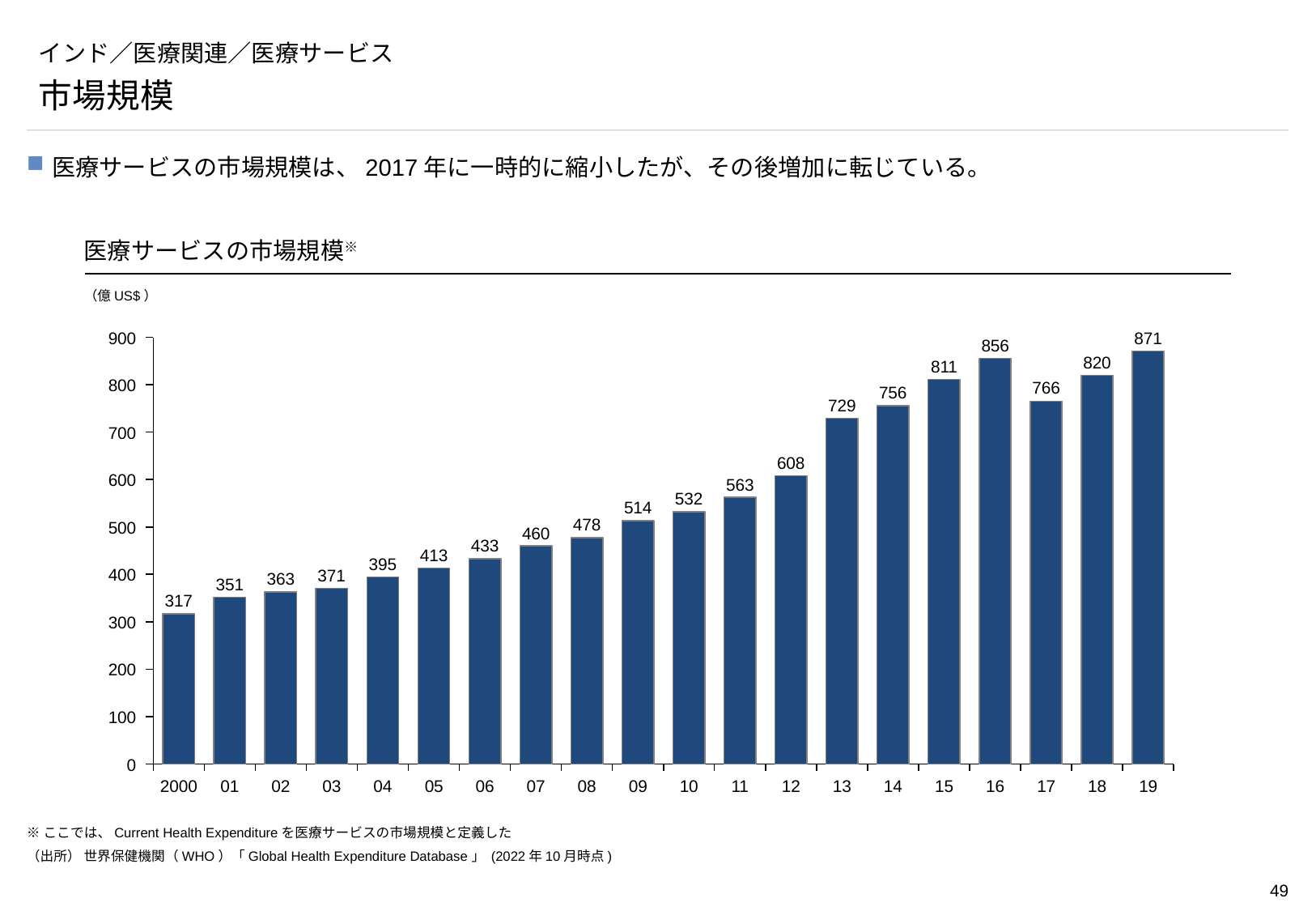
What is the market size value for 2000? 317 What kind of chart is this? bar chart What is the difference between the values for 2016 and 2017? 90 Do the values generally rise or fall from 2000 to 2016? rise How many years are shown on the x axis? 20 What is the market size value for 2019? 871 Which is larger, the value for 2013 or the value for 2017? 2017 What is the value shown for 2017? 766 Which year has the highest value? 19 Is the value for 2012 greater or less than 600? greater What unit is shown for the values on the chart? 億US$ Which year has the lowest value? 2000